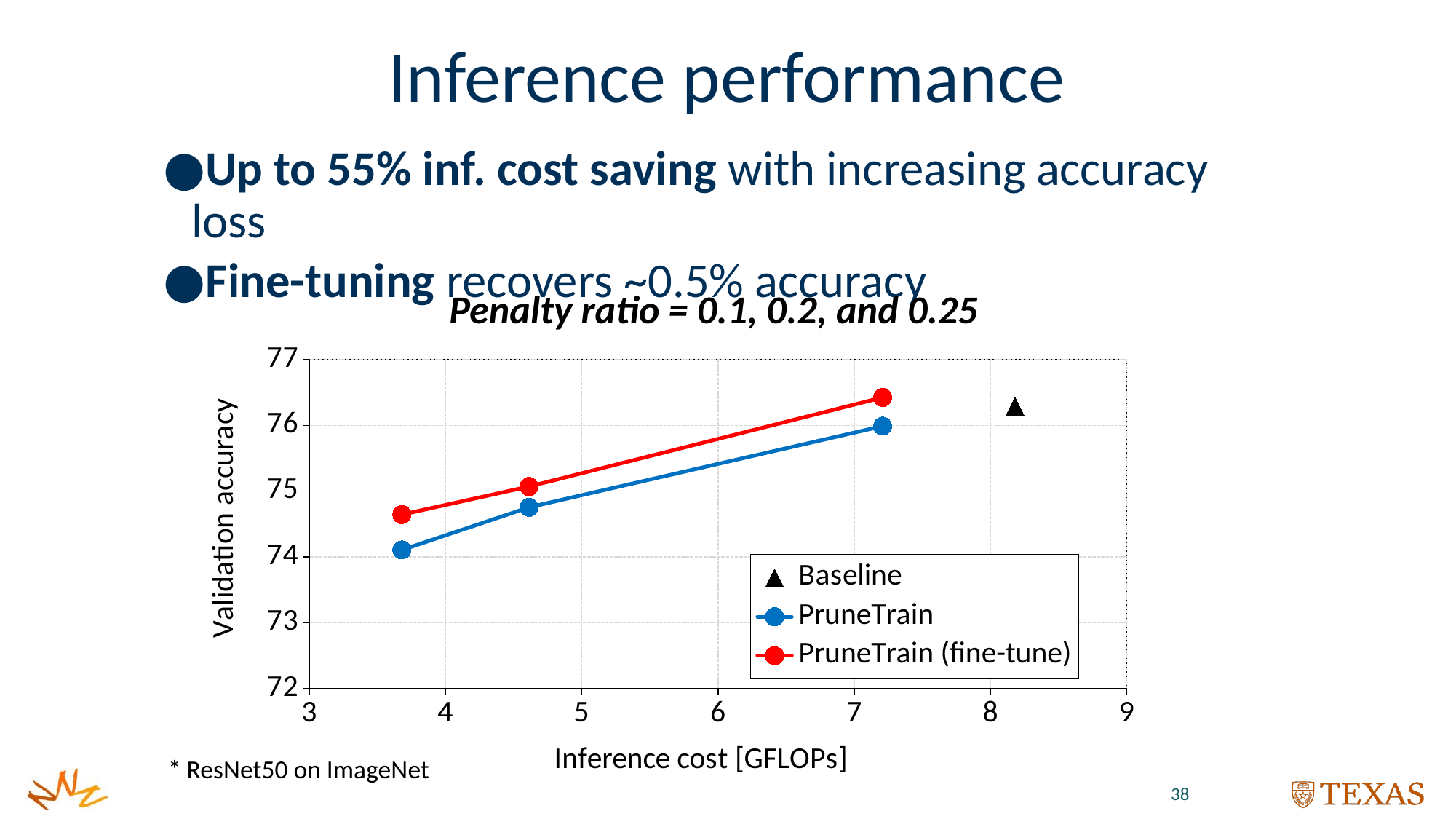
At the lowest inference cost, which series has the higher validation accuracy: PruneTrain or PruneTrain (fine-tune)? PruneTrain (fine-tune) Is the inference cost of the Baseline point greater or less than 8 GFLOPs? greater How many data points are plotted for the Baseline series? 1 Does validation accuracy rise or fall as inference cost increases for the PruneTrain (fine-tune) series? Rise Is the validation accuracy of the Baseline point greater or less than 77? less Is the validation accuracy of the lowest-cost PruneTrain point greater or less than 75? less How many series does the chart legend list? 3 What is the label of the x axis? Inference cost [GFLOPs] What kind of chart is shown on the slide? Line chart Which series is plotted with a black triangle marker? Baseline How many data points are plotted for the PruneTrain series? 3